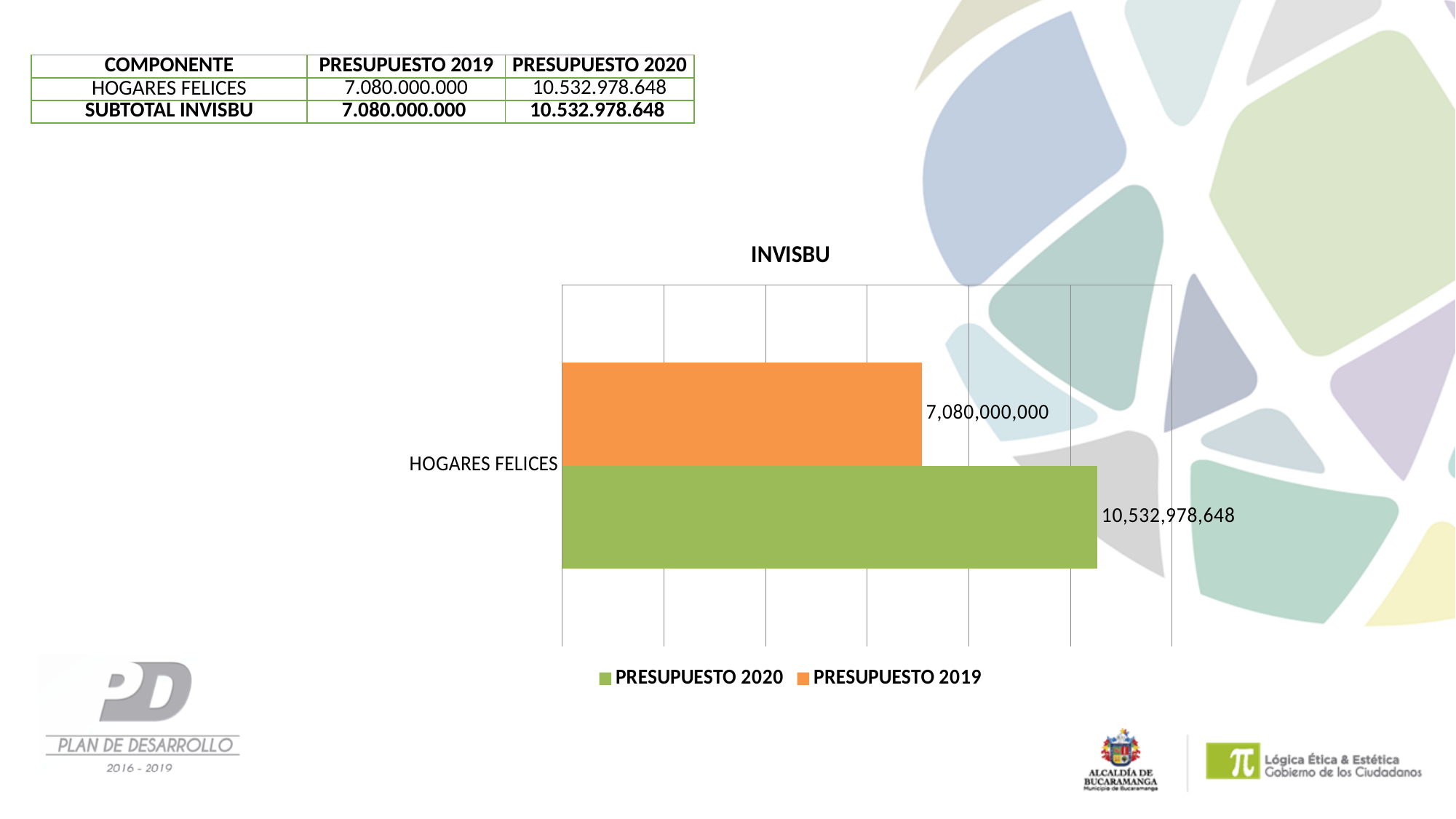
How many series does the chart legend list? 2 What is the value of PRESUPUESTO 2020 for HOGARES FELICES in the chart? 10,532,978,648 Which series has the larger value for HOGARES FELICES, PRESUPUESTO 2020 or PRESUPUESTO 2019? PRESUPUESTO 2020 Which series has the smaller value in the chart? PRESUPUESTO 2019 What is the name of the category plotted in the chart? HOGARES FELICES What kind of chart is shown on the slide? bar chart What is the difference between the PRESUPUESTO 2020 and PRESUPUESTO 2019 values for HOGARES FELICES? 3,452,978,648 Which series is shown in green in the chart? PRESUPUESTO 2020 What is the title of the chart? INVISBU What is the value of PRESUPUESTO 2019 for HOGARES FELICES in the chart? 7,080,000,000 How many categories are plotted in the chart? 1